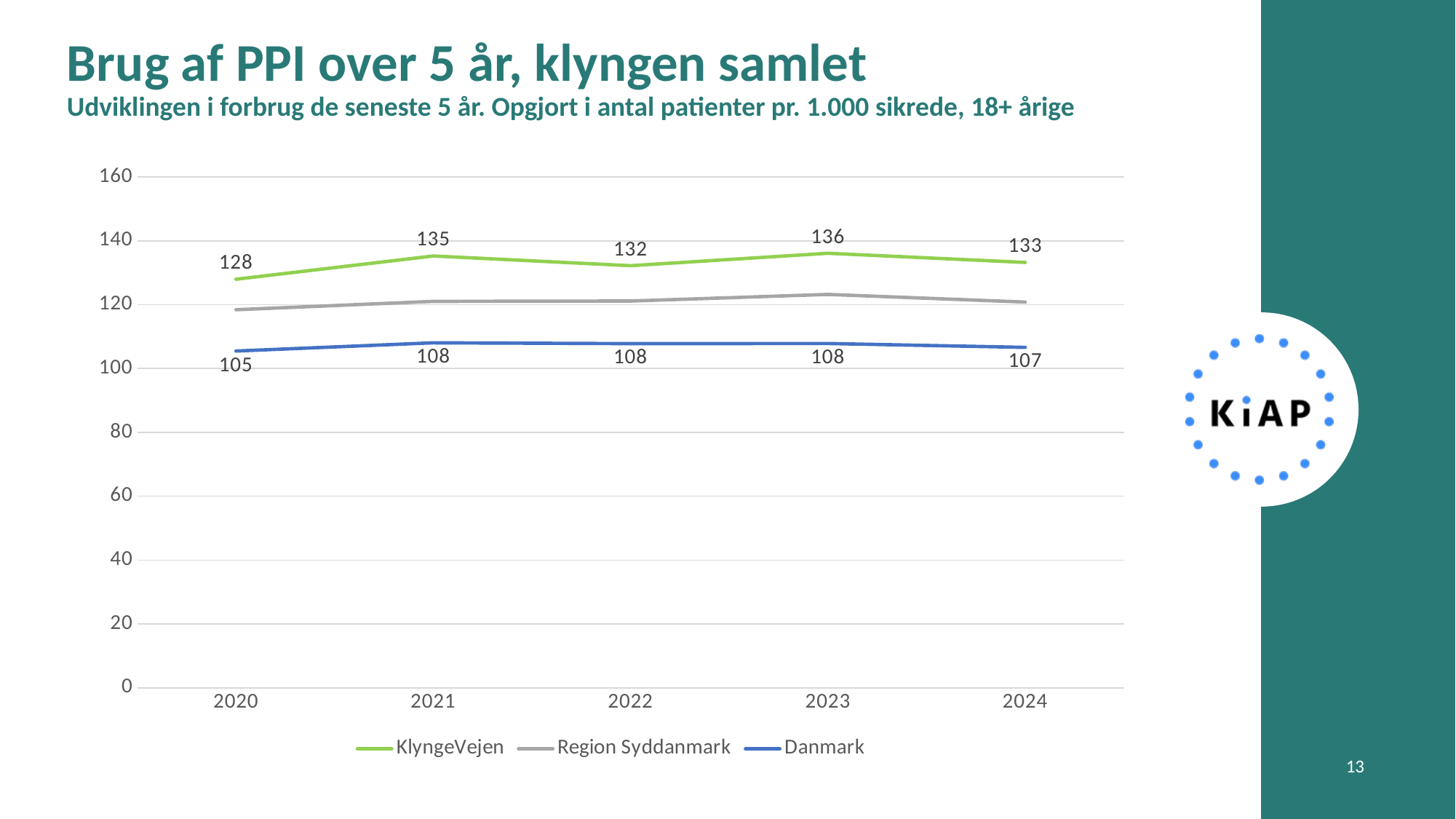
How many years are shown on the x axis? 5 How many series does the legend list? 3 What is the value for Danmark in 2020? 105 What is the difference between the KlyngeVejen and Danmark values in 2021? 27 Which is larger in 2022: the KlyngeVejen value or the Danmark value? KlyngeVejen What is the value for Danmark in 2024? 107 In which year is the KlyngeVejen value highest? 2023 What is the value for KlyngeVejen in 2020? 128 In which year is the KlyngeVejen value lowest? 2020 What kind of chart is shown on the slide? Line chart What is the value for KlyngeVejen in 2023? 136 Is the value for Region Syddanmark in 2023 greater or less than 120? greater